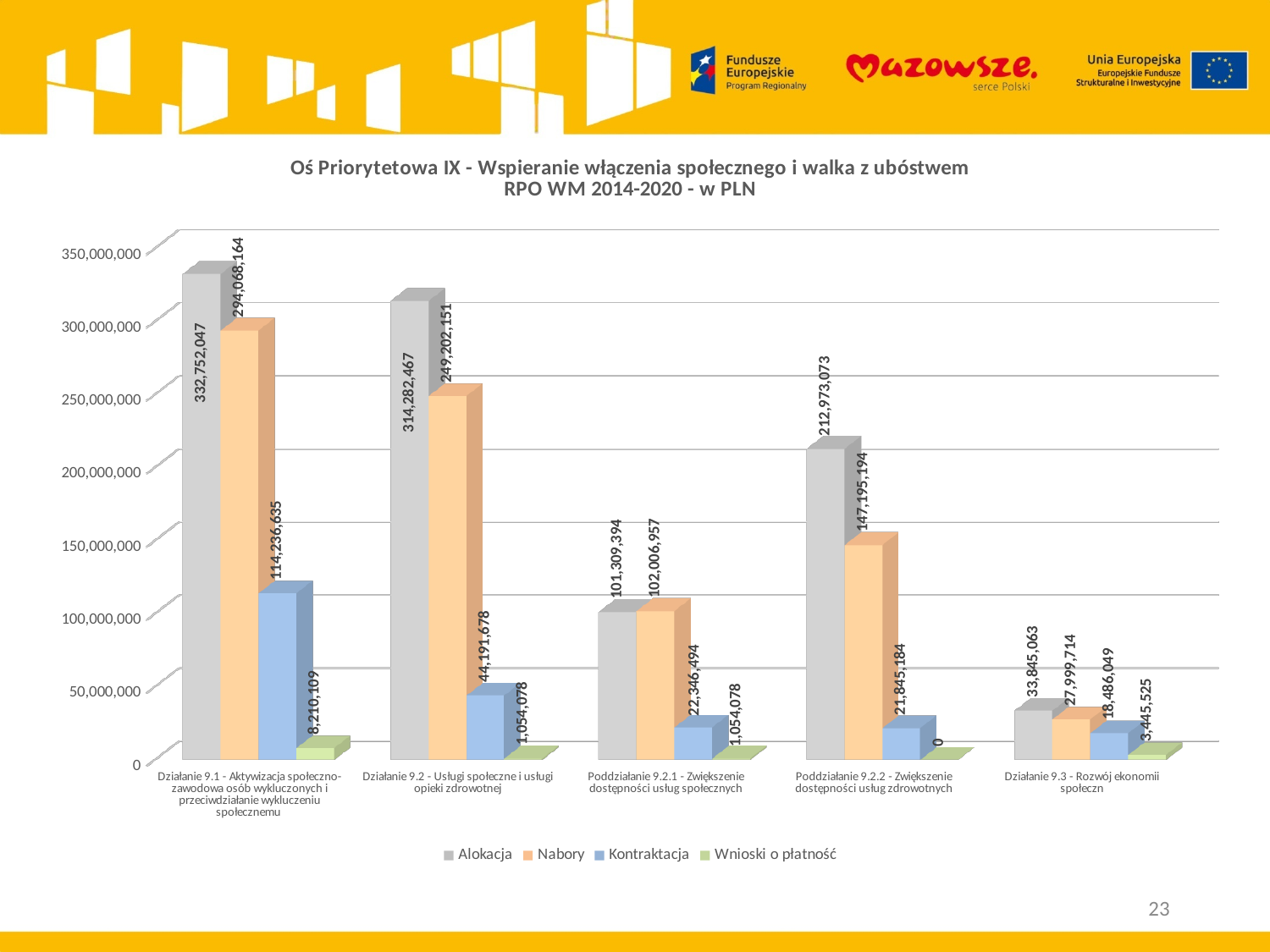
Which category has the lowest Nabory value? Działanie 9.3 How many categories are shown on the x axis? 5 What is the difference between Alokacja and Nabory for Działanie 9.1? 38,683,883 What is the Kontraktacja value for Działanie 9.2 - Usługi społeczne i usługi opieki zdrowotnej? 44,191,678 What kind of chart is shown on the slide? bar chart Which category has the highest Alokacja value? Działanie 9.1 What is the Alokacja value for Działanie 9.1? 332,752,047 How many series does the legend list? 4 For Poddziałanie 9.2.1, which is larger: Alokacja or Nabory? Nabory What is the Wnioski o płatność value for Poddziałanie 9.2.2? 0 Is the Alokacja value for Poddziałanie 9.2.2 greater or less than 200,000,000? greater What is the Wnioski o płatność value for Działanie 9.3 - Rozwój ekonomii społeczn? 3,445,525